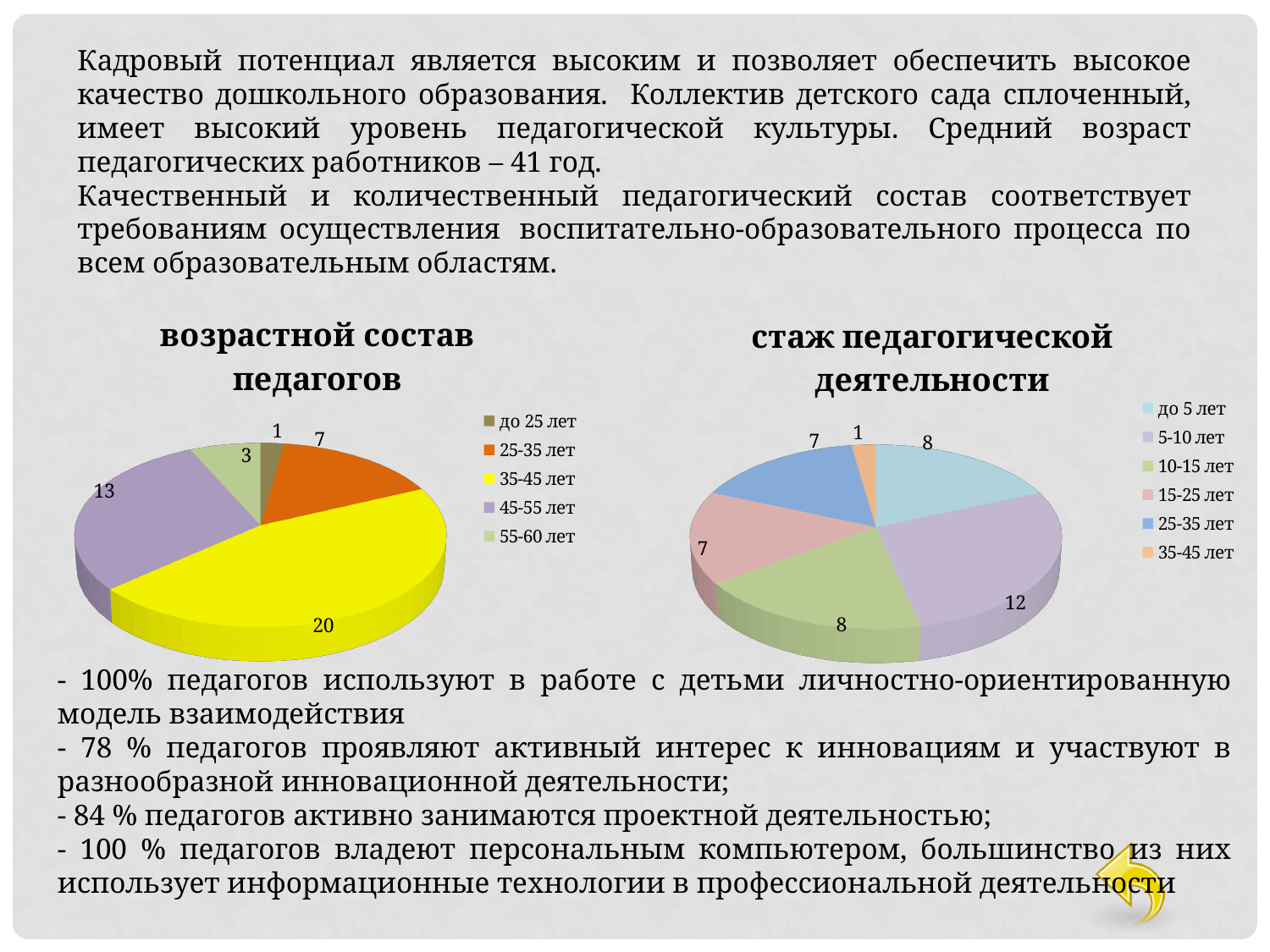
In the chart 'возрастной состав педагогов', what is the value for '35-45 лет'? 20 In the chart 'стаж педагогической деятельности', which is larger: the value for '5-10 лет' or the value for '15-25 лет'? 5-10 лет In the chart 'возрастной состав педагогов', which category has the largest value? 35-45 лет In the chart 'возрастной состав педагогов', what is the difference between the values for '35-45 лет' and '45-55 лет'? 7 In the chart 'стаж педагогической деятельности', which category has the largest value? 5-10 лет In the chart 'стаж педагогической деятельности', how many categories does the legend list? 6 What type of chart is 'стаж педагогической деятельности'? Pie chart In the chart 'возрастной состав педагогов', what is the value for '45-55 лет'? 13 In the chart 'возрастной состав педагогов', which category has the smallest value? до 25 лет In the chart 'стаж педагогической деятельности', what is the value for '35-45 лет'? 1 In the chart 'стаж педагогической деятельности', what is the value for '5-10 лет'? 12 In the chart 'возрастной состав педагогов', how many categories does the legend list? 5